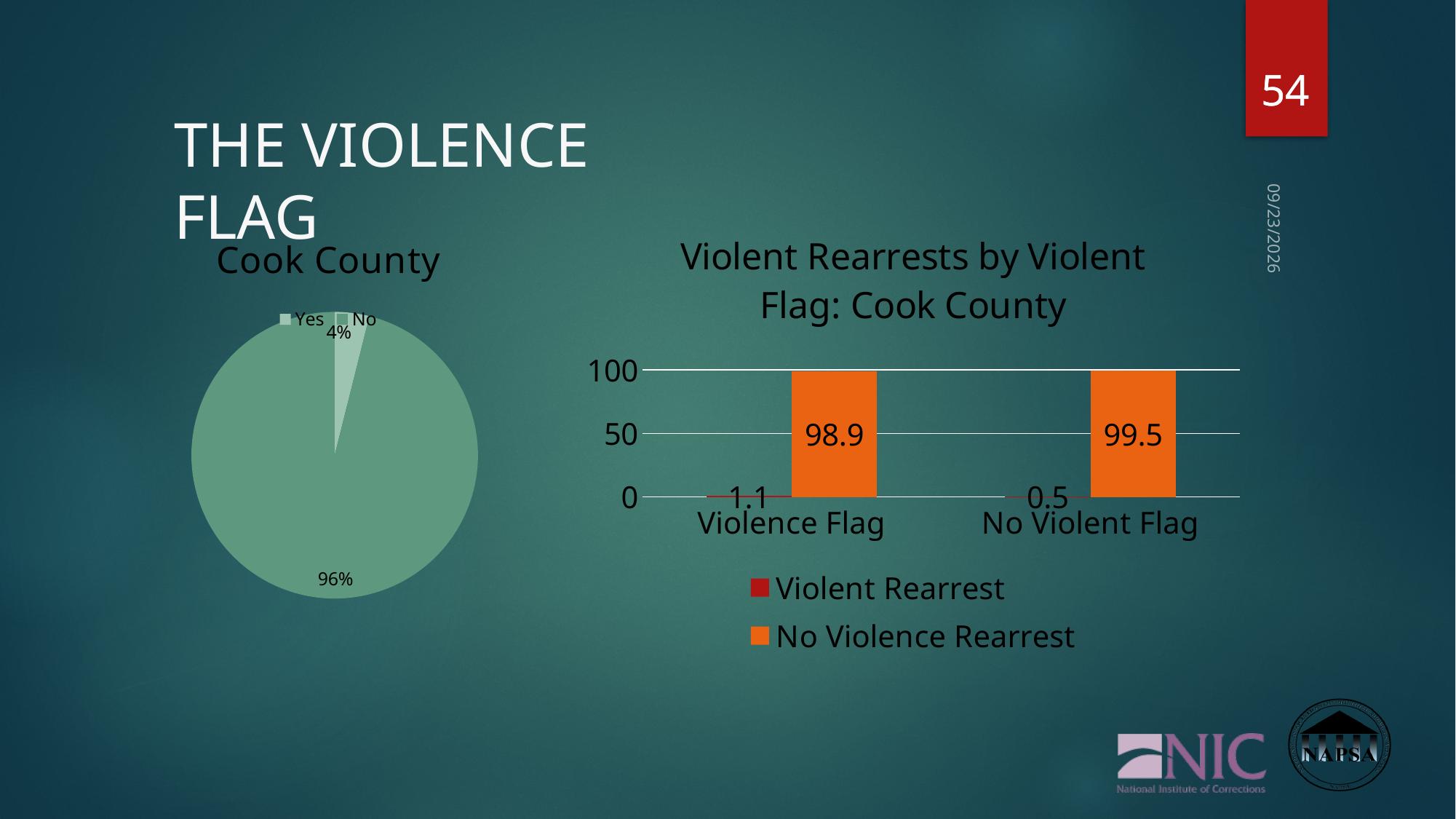
In the 'Cook County' pie chart, what share of the pie is labelled 'No'? 96% In the 'Cook County' pie chart, which slice is larger, 'Yes' or 'No'? No In the 'Violent Rearrests by Violent Flag: Cook County' chart, which category has the higher 'Violent Rearrest' value? Violence Flag How many series does the legend of the 'Violent Rearrests by Violent Flag: Cook County' chart list? 2 What kind of chart is 'Violent Rearrests by Violent Flag: Cook County'? Bar chart In the 'Violent Rearrests by Violent Flag: Cook County' chart, what is the value of 'Violent Rearrest' for 'Violence Flag'? 1.1 In the 'Cook County' pie chart, what share of the pie is labelled 'Yes'? 4% How many slices does the 'Cook County' pie chart have? 2 In the 'Violent Rearrests by Violent Flag: Cook County' chart, what is the value of 'No Violence Rearrest' for 'Violence Flag'? 98.9 In the 'Violent Rearrests by Violent Flag: Cook County' chart, what is the value of 'Violent Rearrest' for 'No Violent Flag'? 0.5 What kind of chart is the 'Cook County' chart on the left? Pie chart In the 'Violent Rearrests by Violent Flag: Cook County' chart, what is the difference between the 'No Violence Rearrest' values for 'No Violent Flag' and 'Violence Flag'? 0.6